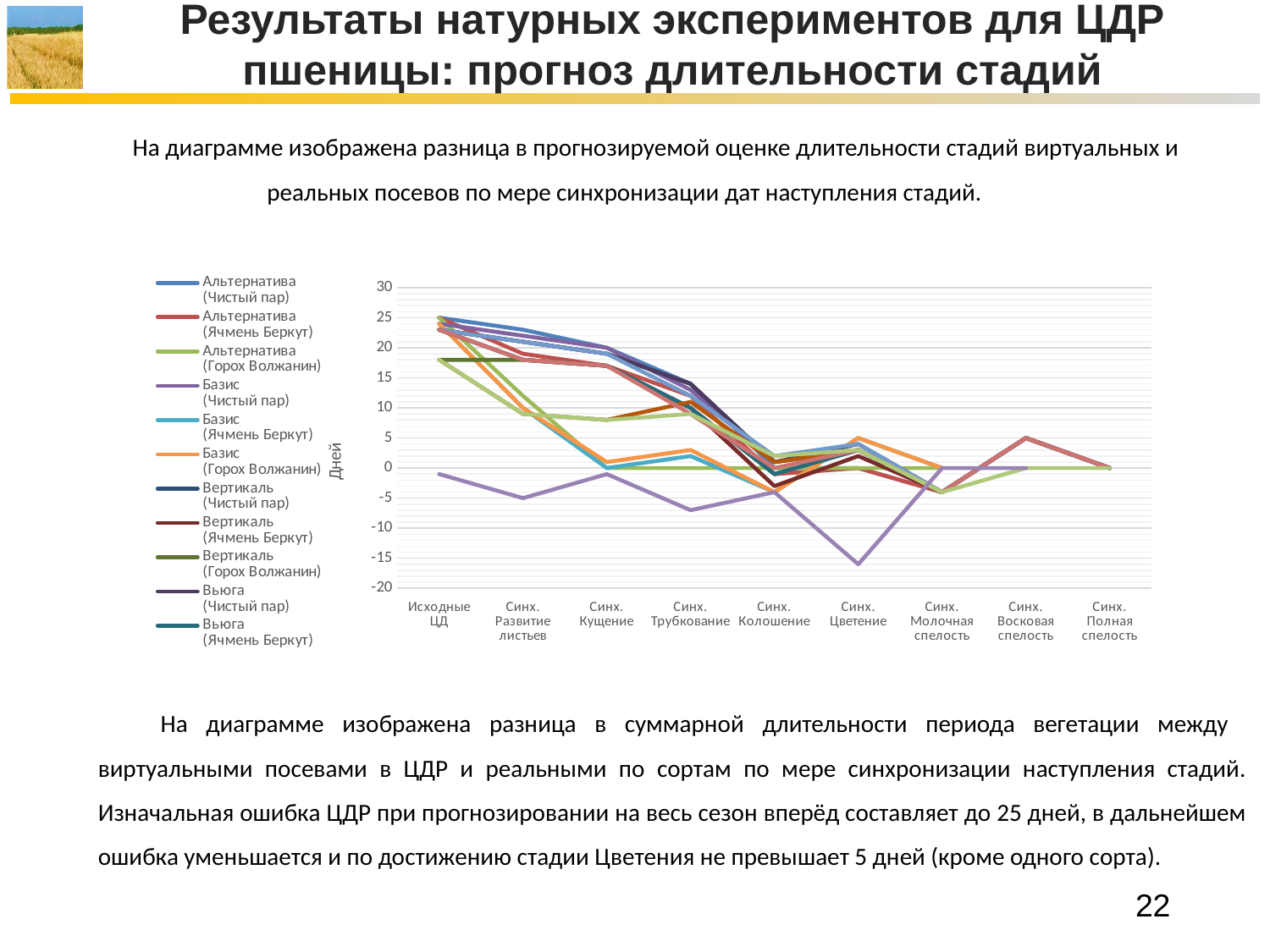
Is the value for Альтернатива (Ячмень Беркут) at Синх. Кущение greater or less than 10? greater How many series does the chart legend list? 11 Does the value for Альтернатива (Чистый пар) rise or fall from Исходные ЦД to Синх. Колошение? fall What is the highest tick value shown on the vertical axis of the chart? 30 Is the value for Базис (Чистый пар) at Синх. Цветение greater or less than -10? greater Is the value for Базис (Чистый пар) at Исходные ЦД greater or less than 5? greater What is the label of the vertical axis of the chart? Дней How many categories are shown along the x axis of the chart? 9 What kind of chart is shown on the slide? line chart What is the first category on the x axis of the chart? Исходные ЦД